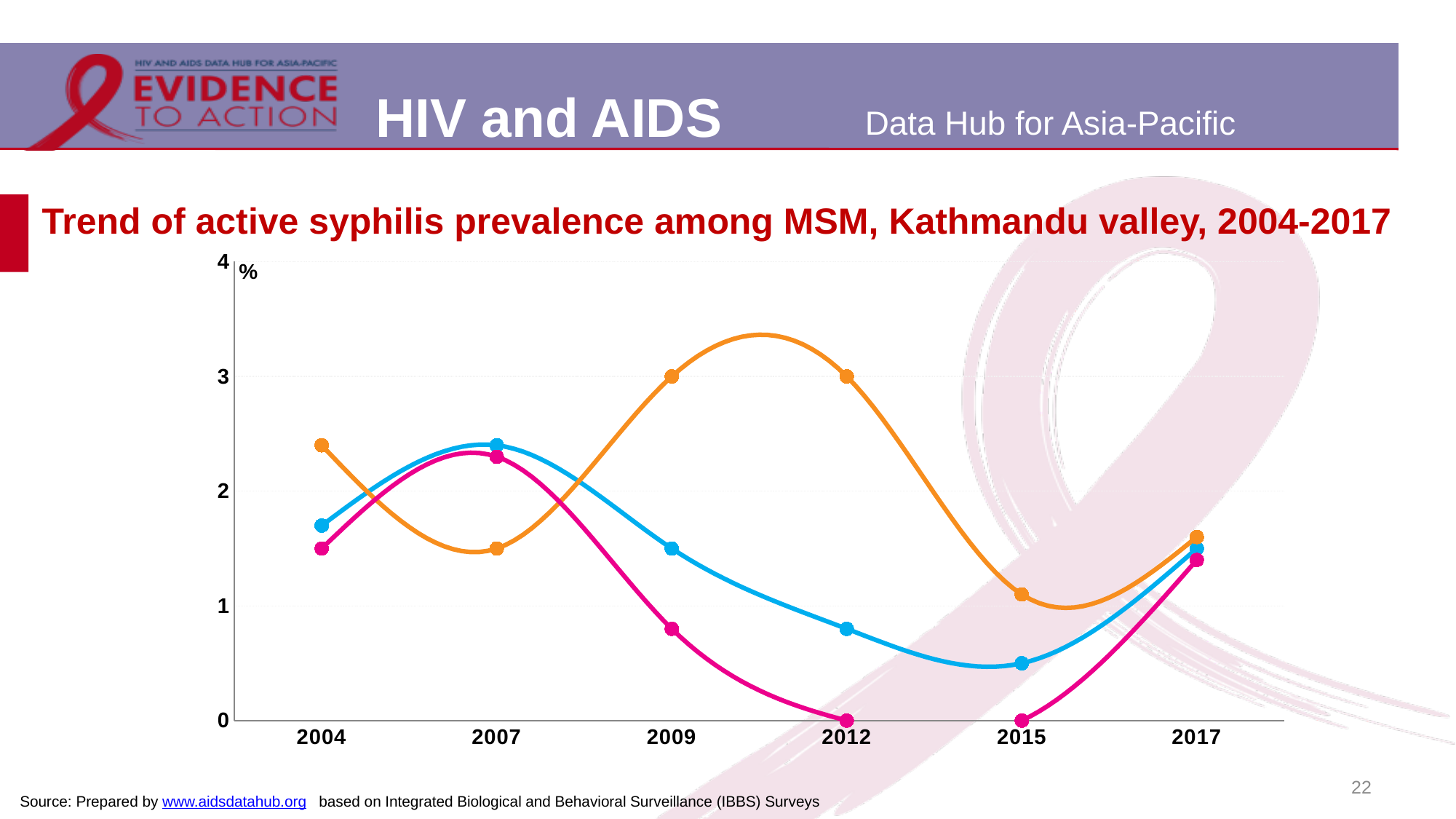
How many years are shown on the x axis of the chart? 6 Is the value of the pink line in 2009 greater or less than 1? less Which line has the higher value in 2012, the orange line or the blue line? orange line In which year does the orange line reach its lowest value? 2015 What is the value of the pink line in 2012? 0 What is the value of the orange line in 2009? 3 Does the blue line rise or fall between 2007 and 2015? fall What is the value of the pink line in 2015? 0 What is the value of the orange line in 2012? 3 Is the value of the blue line in 2015 greater or less than 1? less What kind of chart is shown on the slide? line chart Is the value of the orange line in 2004 greater or less than 2? greater